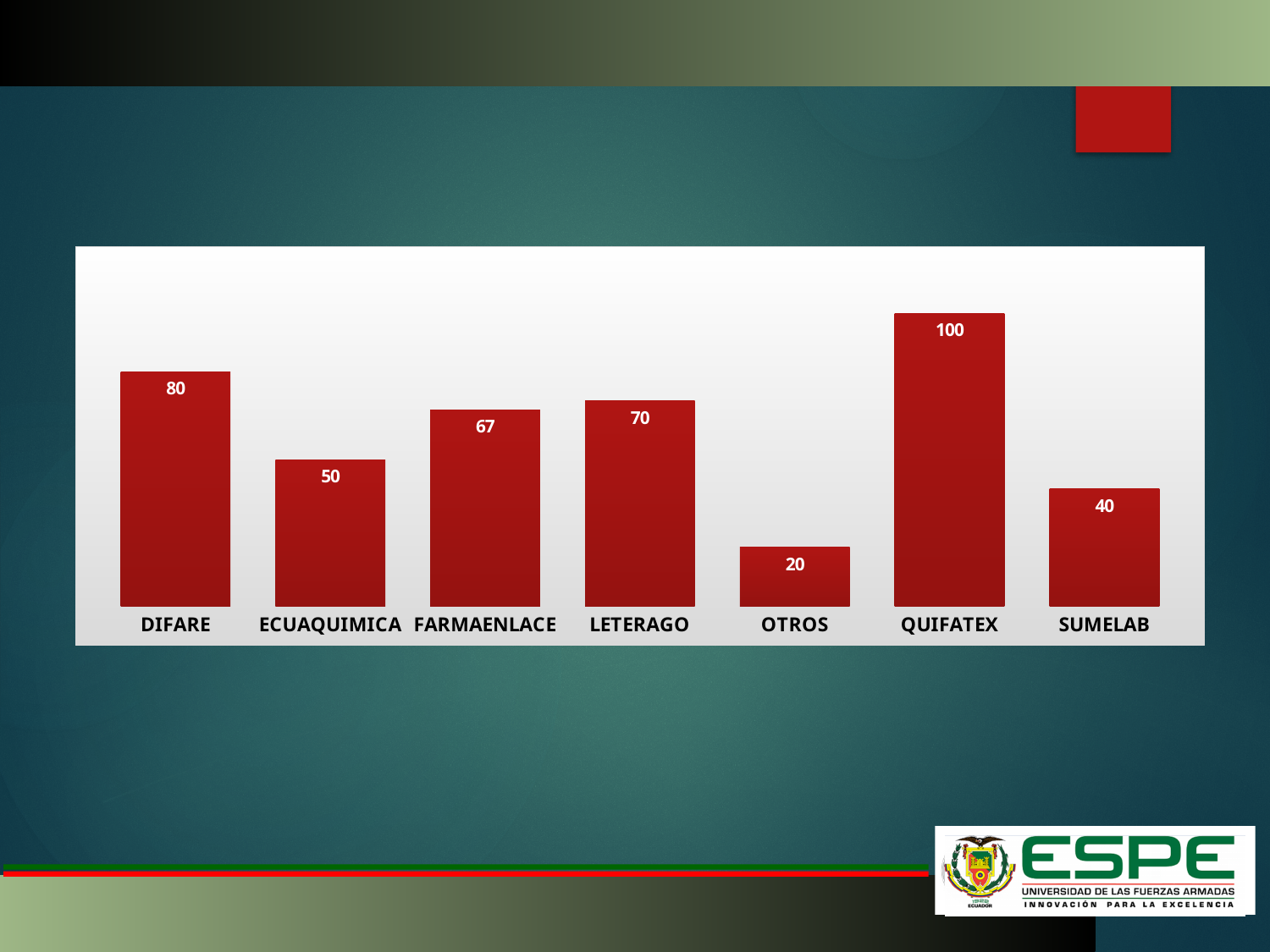
What is the difference between the values for LETERAGO and ECUAQUIMICA? 20 What is the value for OTROS? 20 How many categories are shown in the chart? 7 Which category has the highest value? QUIFATEX What colour are the bars in the chart? Red What is the value for FARMAENLACE? 67 Which is larger, the value for LETERAGO or the value for FARMAENLACE? LETERAGO What is the value for DIFARE? 80 What is the difference between the values for QUIFATEX and DIFARE? 20 What is the value for SUMELAB? 40 Which category has the lowest value? OTROS What kind of chart is shown on the slide? Bar chart